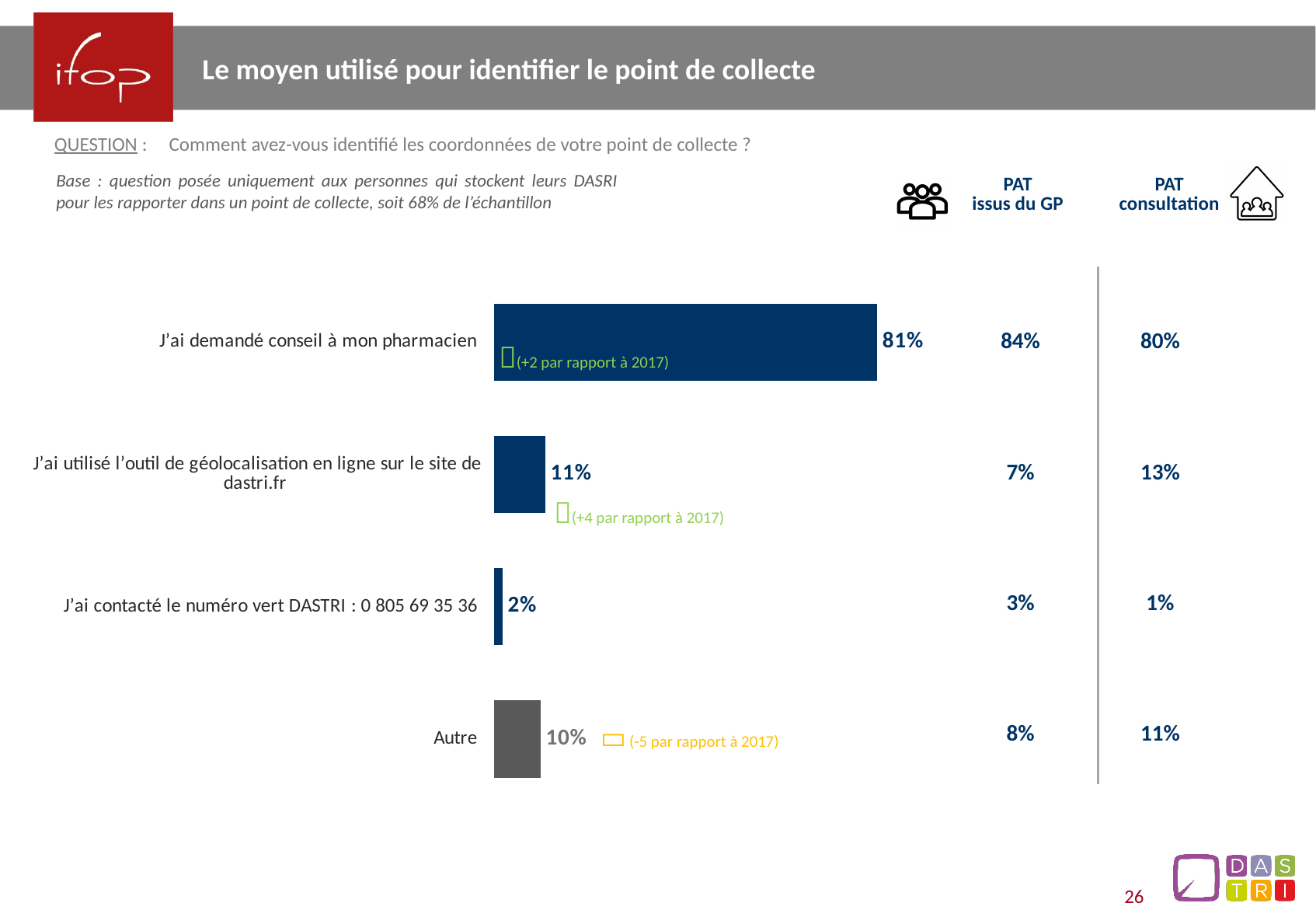
What percentage of respondents said they asked their pharmacist for advice ("J'ai demandé conseil à mon pharmacien")? 81% Which bar in the chart is coloured grey rather than dark blue? Autre What type of chart is shown on the slide? Bar chart According to the annotation, how did the value for "J'ai demandé conseil à mon pharmacien" change compared with 2017? +2 par rapport à 2017 Which is larger: the value for "J'ai utilisé l'outil de géolocalisation en ligne sur le site de dastri.fr" or the value for "Autre"? J'ai utilisé l'outil de géolocalisation en ligne sur le site de dastri.fr What is the difference between the value for "J'ai demandé conseil à mon pharmacien" and the value for "J'ai utilisé l'outil de géolocalisation en ligne sur le site de dastri.fr"? 70 percentage points What is the value shown for the "Autre" category? 10% Which category has the lowest value in the bar chart? J'ai contacté le numéro vert DASTRI : 0 805 69 35 36 How many categories are shown in the bar chart? 4 What is the value shown for "J'ai utilisé l'outil de géolocalisation en ligne sur le site de dastri.fr"? 11% What is the value shown for "J'ai contacté le numéro vert DASTRI : 0 805 69 35 36"? 2% Which category has the highest value in the bar chart? J'ai demandé conseil à mon pharmacien